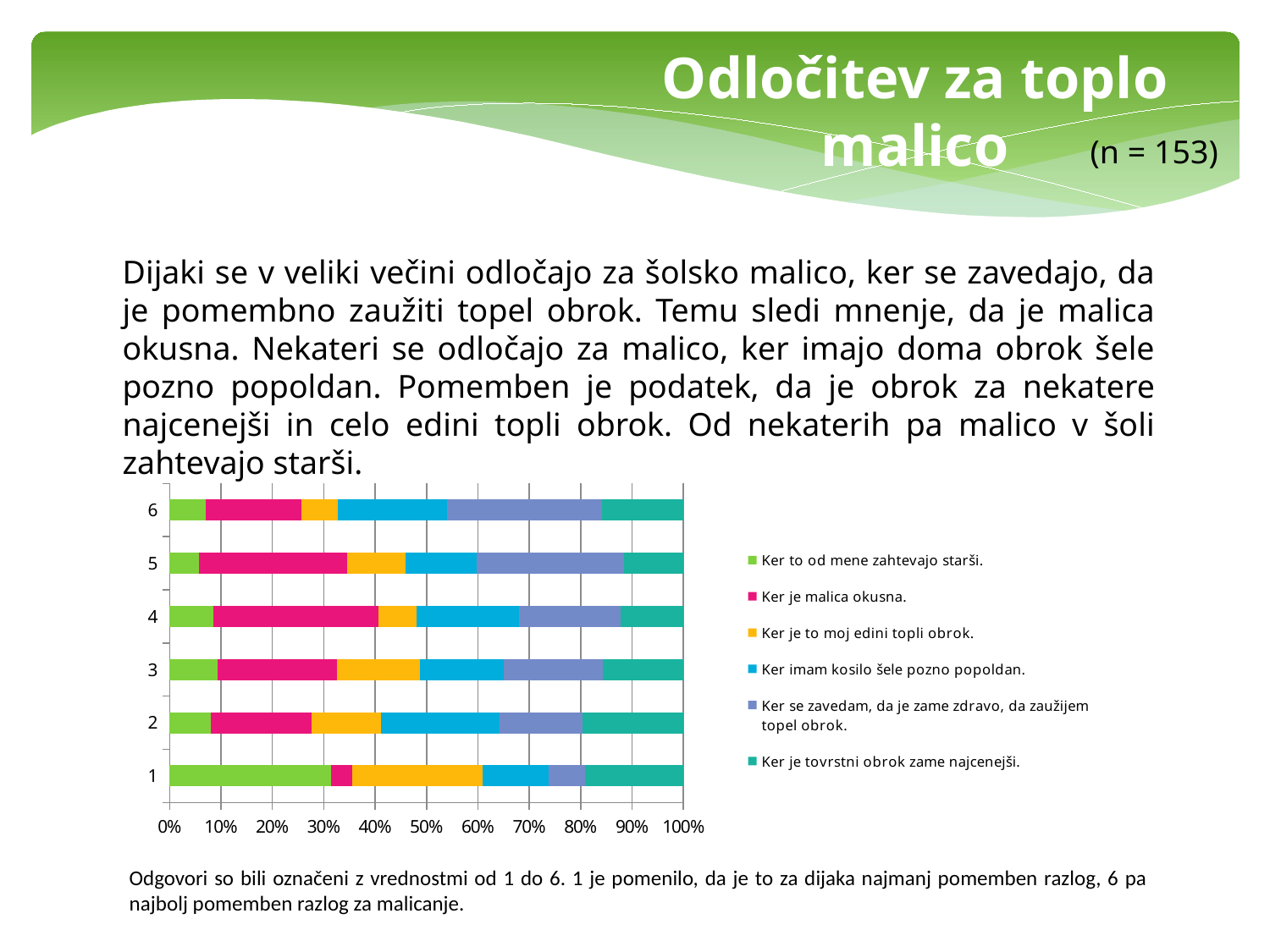
What kind of chart is shown on the slide? Stacked bar chart Is the share for "Ker to od mene zahtevajo starši." in category 6 greater or less than 10%? less Which category has a larger share for "Ker je to moj edini topli obrok.", category 1 or category 6? 1 Is the share for "Ker je malica okusna." in category 1 greater or less than 10%? less Which legend entry is listed first in the chart legend? Ker to od mene zahtevajo starši. Is the share for "Ker to od mene zahtevajo starši." in category 1 greater or less than 20%? greater How many series does the chart legend list? 6 Which category has the largest share for "Ker to od mene zahtevajo starši."? 1 How many categories (rating values) are shown on the vertical axis of the chart? 6 What colour represents the series "Ker je malica okusna." in the chart? Pink Which category has the smallest share for "Ker je malica okusna."? 1